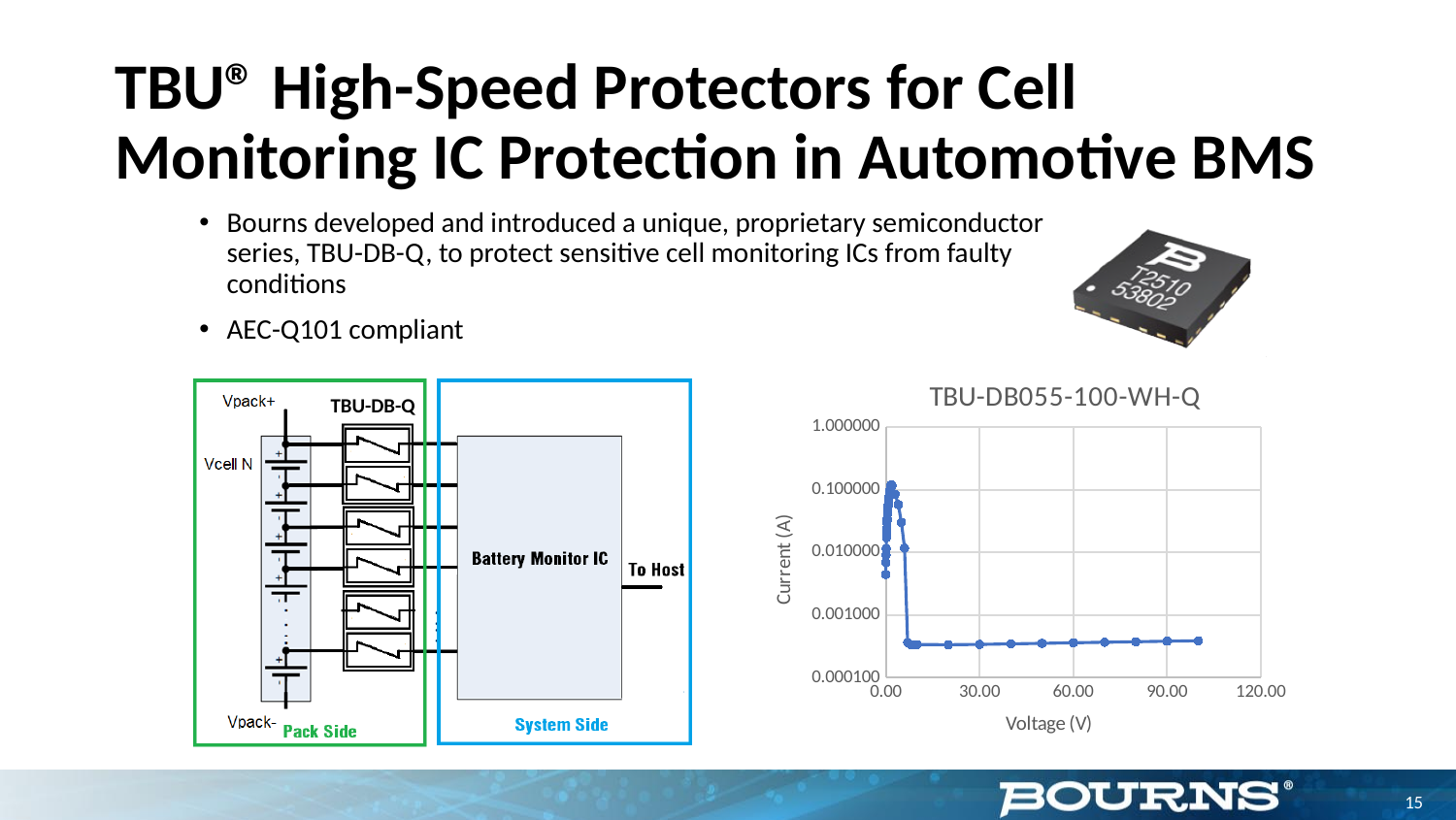
Is the peak current reached near 0 V greater or less than 0.010000 A? greater Is the current at 30.00 V greater or less than 0.001000 A? less What quantity is plotted on the vertical axis of the chart? Current (A) Is the current at 90.00 V greater or less than 0.001000 A? less What type of chart is shown on the slide? Line chart Does the current rise or fall as the voltage increases from about 5 V to about 10 V? fall What is the lowest current tick shown on the y axis? 0.000100 Is the current at 60.00 V higher or lower than the peak current near 0 V? lower What is the largest voltage tick shown on the x axis? 120.00 What is the title of the chart on the slide? TBU-DB055-100-WH-Q